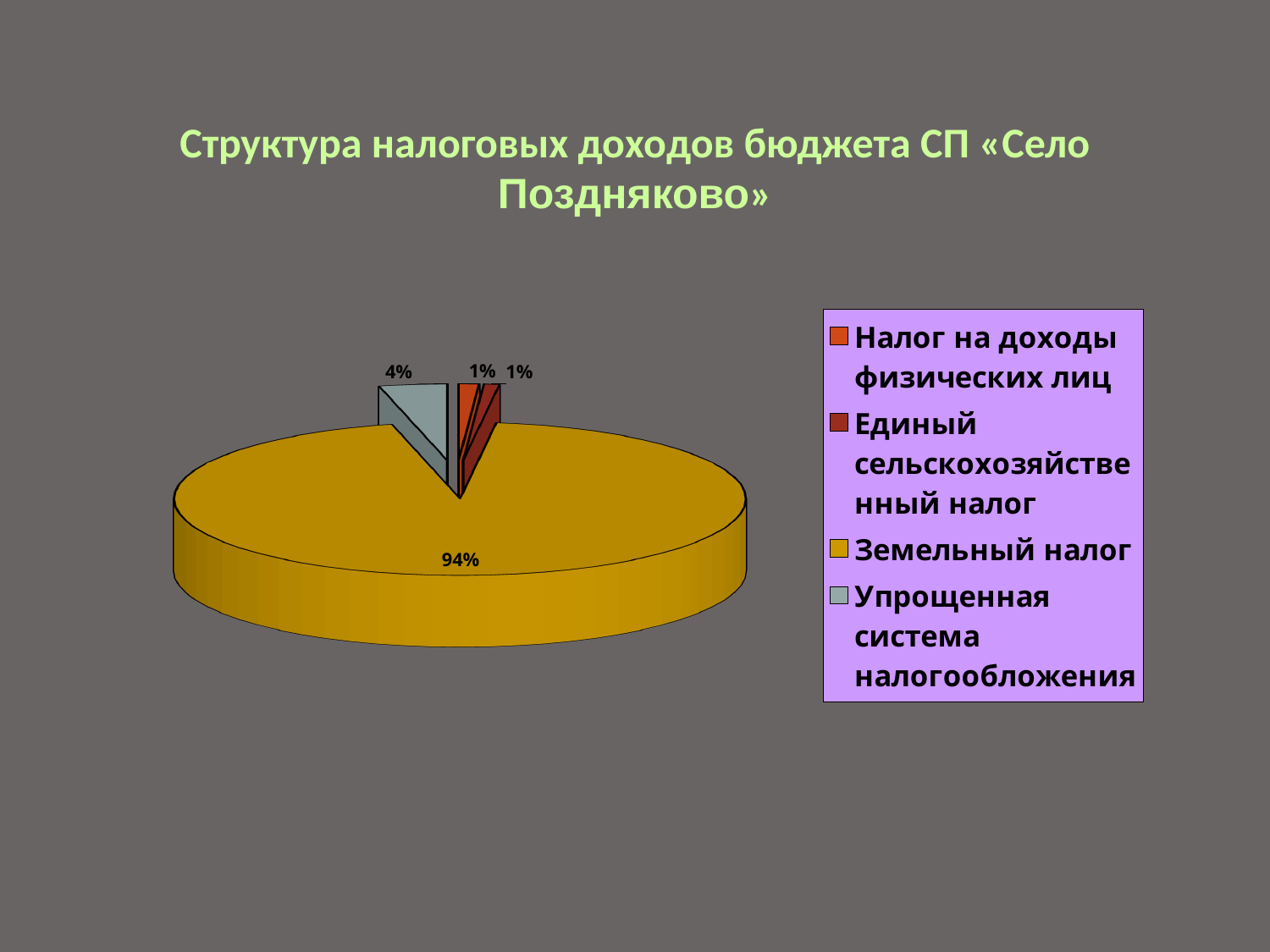
What share of the pie does Налог на доходы физических лиц take? 1% What kind of chart is shown on the slide? pie chart What is the title of the chart on the slide? Структура налоговых доходов бюджета СП «Село Поздняково» What is the difference in percentage points between Земельный налог and Упрощенная система налогообложения? 90 Is the share for Земельный налог greater or less than 50%? greater Which is larger, the slice for Упрощенная система налогообложения or the slice for Налог на доходы физических лиц? Упрощенная система налогообложения What share of the pie does Земельный налог take? 94% How many categories does the legend list? 4 What share of the pie does Упрощенная система налогообложения take? 4% Which category has the largest slice of the pie? Земельный налог What colour is the slice for Земельный налог? yellow